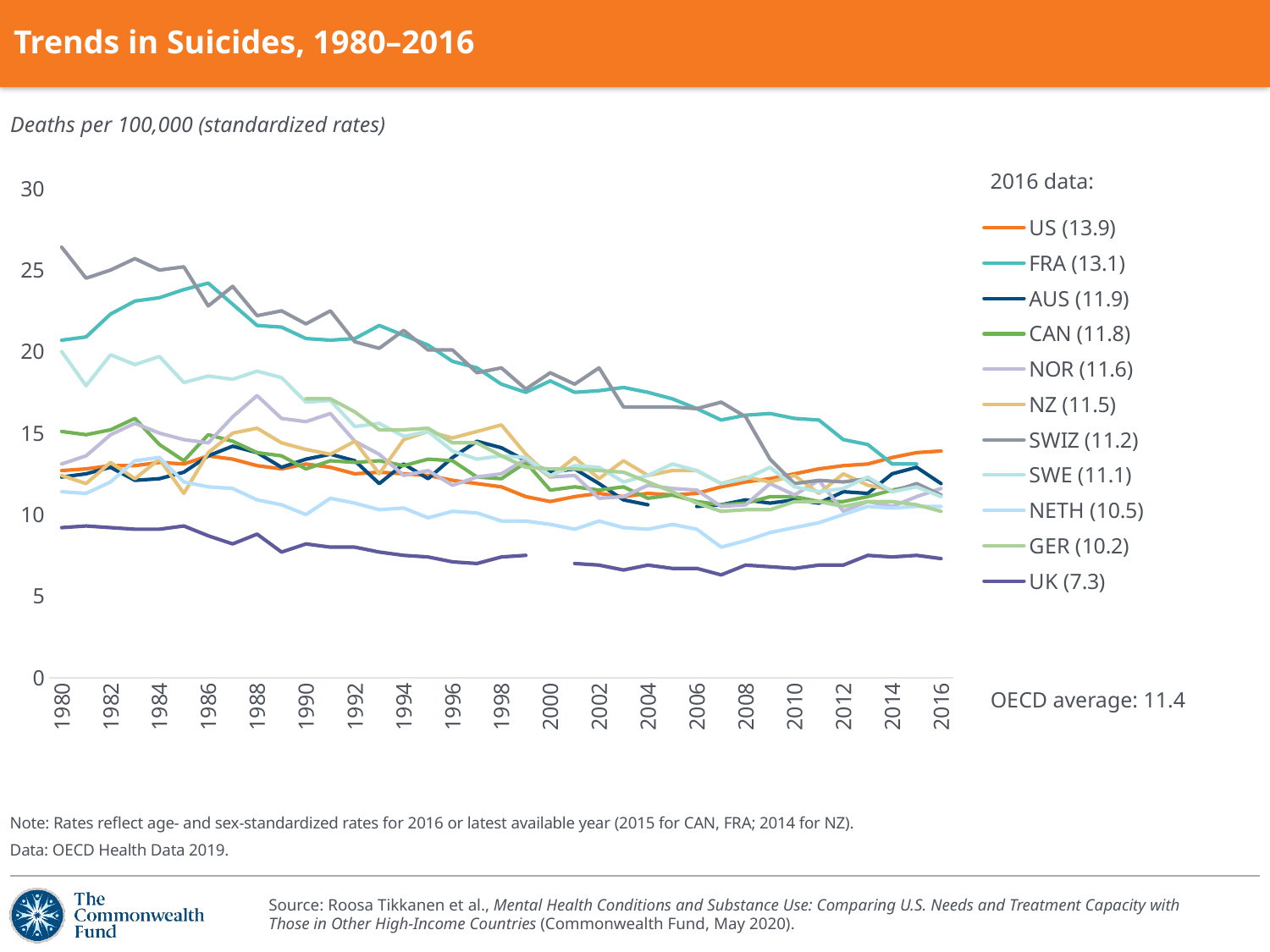
What is the 2016 suicide rate for the US shown in the legend? 13.9 What kind of chart is shown on the slide? line chart Which has the larger 2016 value, FRA or AUS? FRA What is the 2016 suicide rate for the UK shown in the legend? 7.3 Is the value for the UK in 1980 greater or less than 10? less What OECD average is stated on the slide? 11.4 What is the difference between the 2016 values for the US and the UK? 6.6 Which country has the highest 2016 value in the legend? US How many countries (series) does the legend list? 11 Is the value for SWIZ in 1980 greater or less than 25? greater Does the SWIZ line generally rise or fall from 1980 to 2016? fall Which country has the lowest 2016 value in the legend? UK